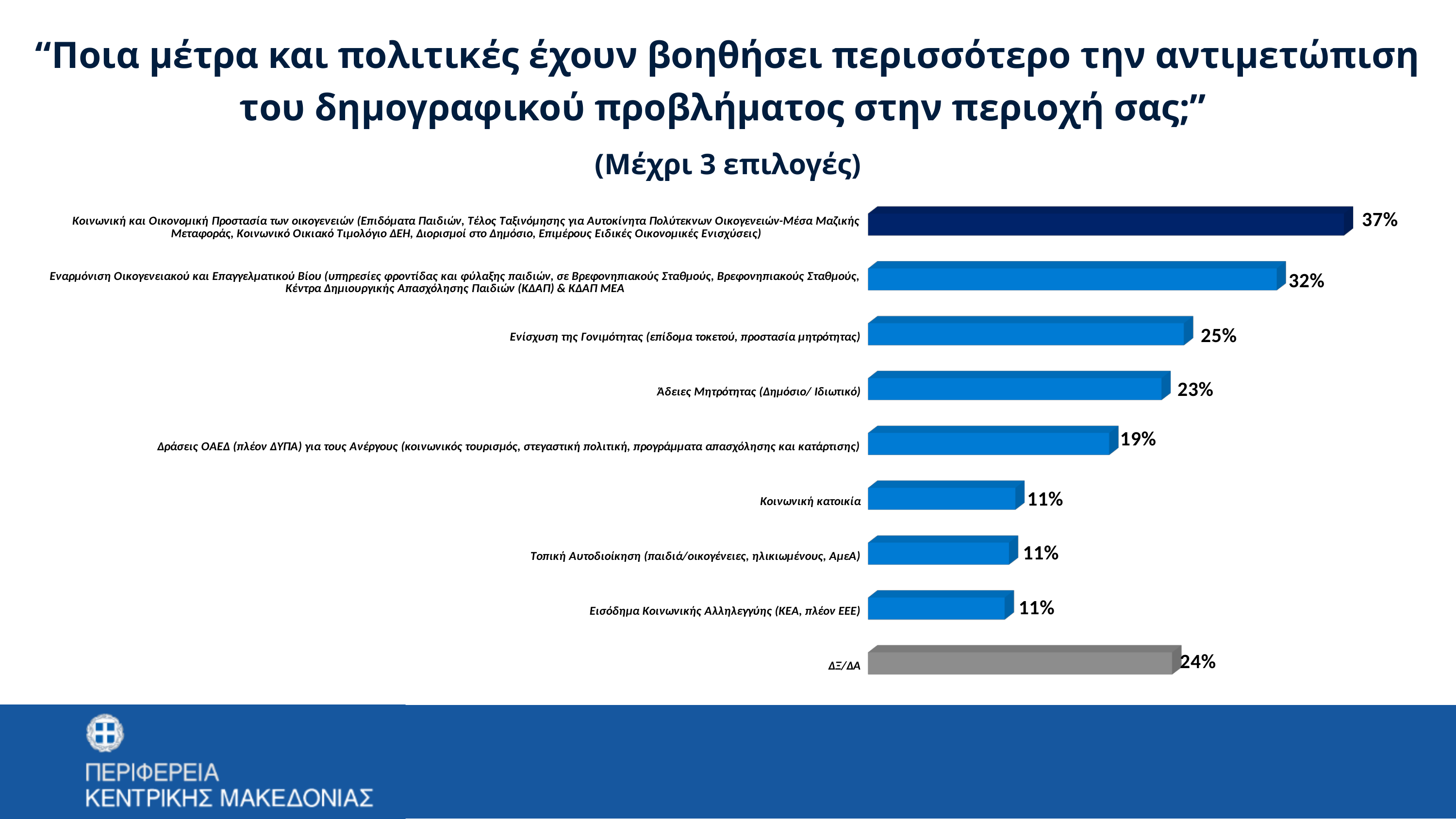
Which is larger: the percentage for "Δράσεις ΟΑΕΔ (πλέον ΔΥΠΑ) για τους Ανέργους" or for "ΔΞ/ΔΑ"? ΔΞ/ΔΑ What percentage is shown for "Ενίσχυση της Γονιμότητας (επίδομα τοκετού, προστασία μητρότητας)"? 25% What is the difference between the percentage for "Ενίσχυση της Γονιμότητας" and "Κοινωνική κατοικία"? 14% What is the difference between the percentage for "Κοινωνική και Οικονομική Προστασία των οικογενειών" and "Εναρμόνιση Οικογενειακού και Επαγγελματικού Βίου"? 5% Which category has the highest percentage? Κοινωνική και Οικονομική Προστασία των οικογενειών How many bars are shown on the chart? 9 What is the lowest percentage shown on the chart? 11% What percentage is shown for "Κοινωνική κατοικία"? 11% What percentage is shown for "ΔΞ/ΔΑ"? 24% What colour is the bar for "ΔΞ/ΔΑ"? grey What percentage is shown for "Άδειες Μητρότητας (Δημόσιο/ Ιδιωτικό)"? 23% What kind of chart is shown on the slide? bar chart